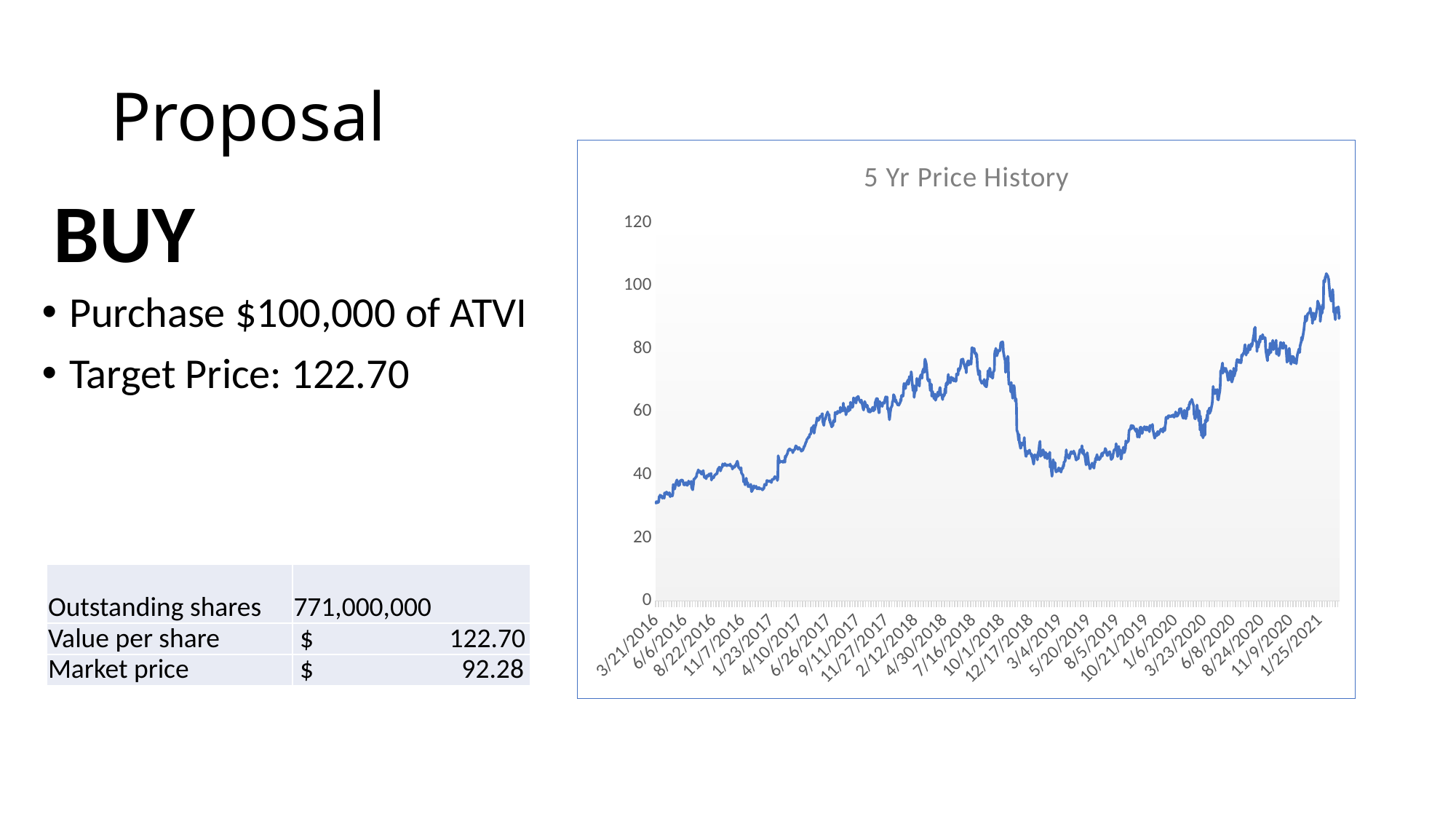
What kind of chart is shown on the slide? line chart Is the value at 3/4/2019 greater or less than 60? less Near which labelled date on the x axis is the line at its lowest? 3/21/2016 Is the value at 4/30/2018 greater or less than 60? greater What is the highest value shown on the chart's vertical axis? 120 Is the value at 1/25/2021 greater or less than 80? greater Which is larger, the value at 4/30/2018 or the value at 3/4/2019? 4/30/2018 Overall, does the price rise or fall from the first date (3/21/2016) to the last date (1/25/2021)? rise What is the title of the chart? 5 Yr Price History Which is larger, the value at 1/25/2021 or the value at 3/21/2016? 1/25/2021